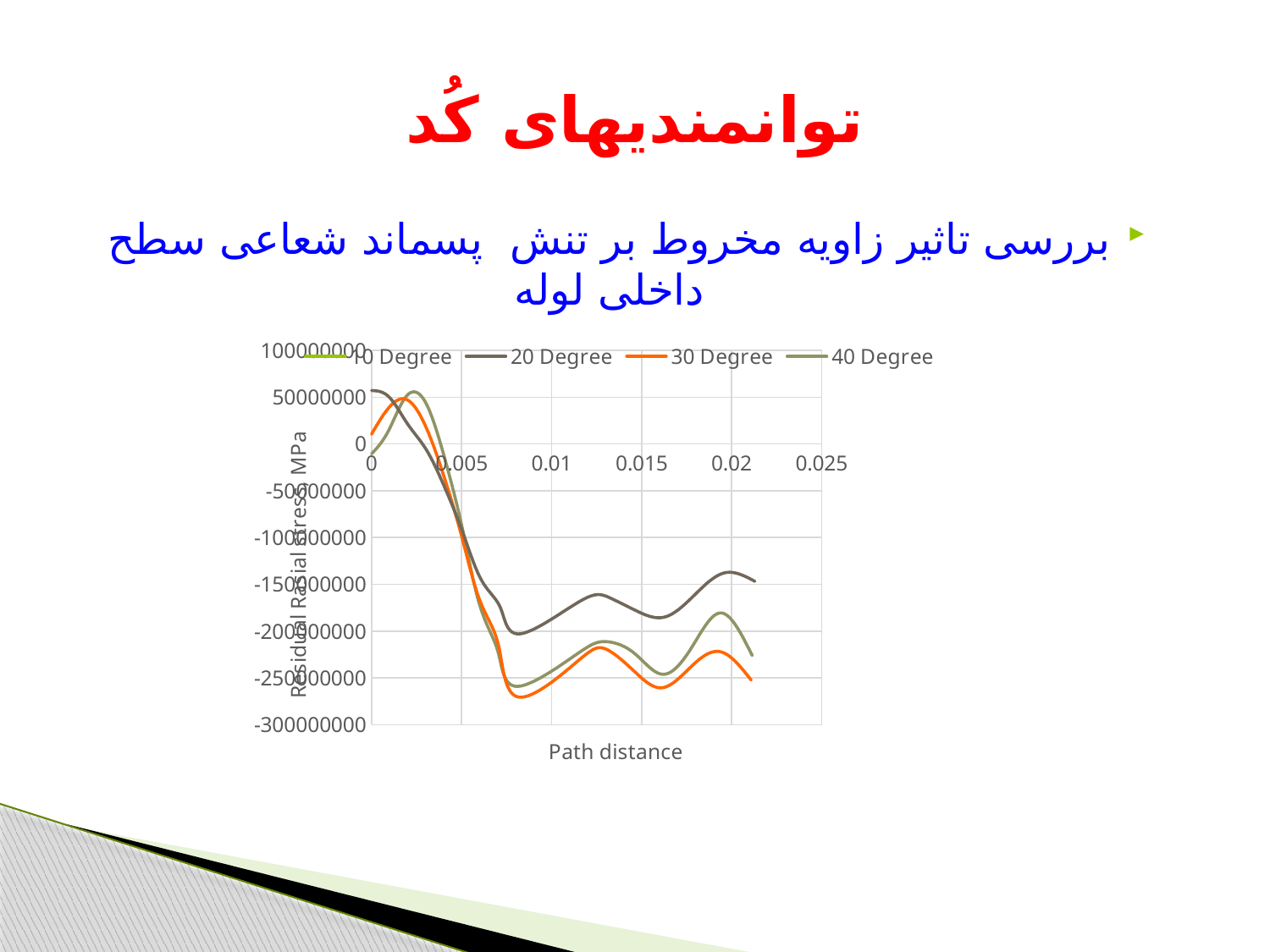
Which series reaches the lowest value on the chart? 30 Degree Which series is drawn in orange on the chart? 30 Degree What kind of chart is shown on the slide? line chart Do the values of the 20 Degree series rise or fall between path distance 0.003 and 0.008? fall Is the lowest value of the 30 Degree series greater or less than -250000000? less How many series does the chart legend list? 4 What is the label of the x axis of the chart? Path distance Is the lowest value of the 20 Degree series greater or less than -250000000? greater Is the value of the 20 Degree series at a path distance of 0.02 greater or less than -100000000? less What is the label of the y axis of the chart? Residual Radial Stress MPa At a path distance of 0.02, which series has the larger value, 20 Degree or 30 Degree? 20 Degree